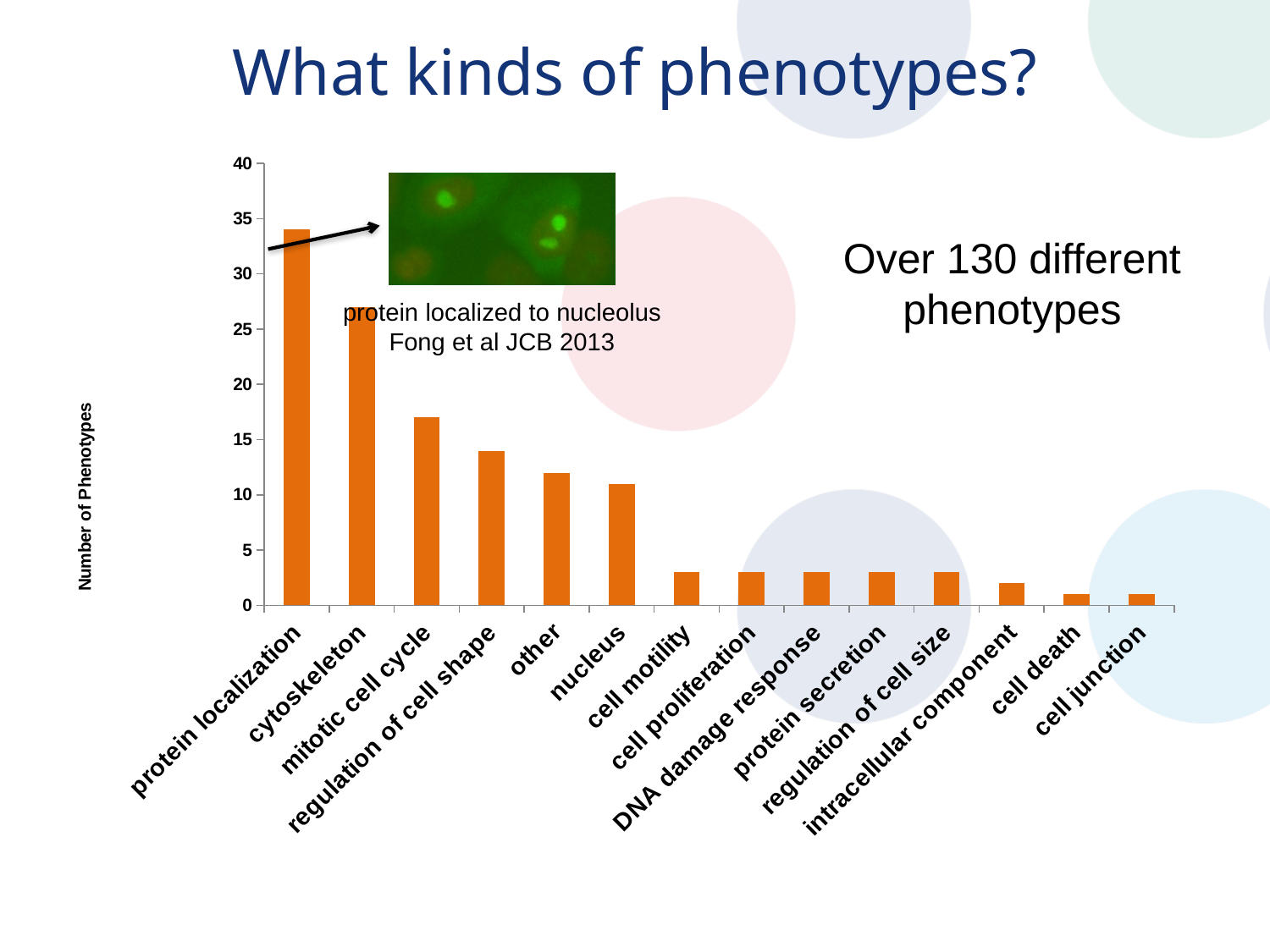
Is the value for protein localization greater or less than 30? greater Is the value for cell motility greater or less than 5? less Which category has the highest number of phenotypes? protein localization Do the bar values rise or fall from left to right along the x axis? fall Which has more phenotypes, cytoskeleton or mitotic cell cycle? cytoskeleton What kind of chart is shown on the slide? bar chart Is the value for mitotic cell cycle greater or less than 20? less How many phenotype categories are plotted on the x axis? 14 What is the label of the y axis? Number of Phenotypes Which has more phenotypes, regulation of cell shape or nucleus? regulation of cell shape